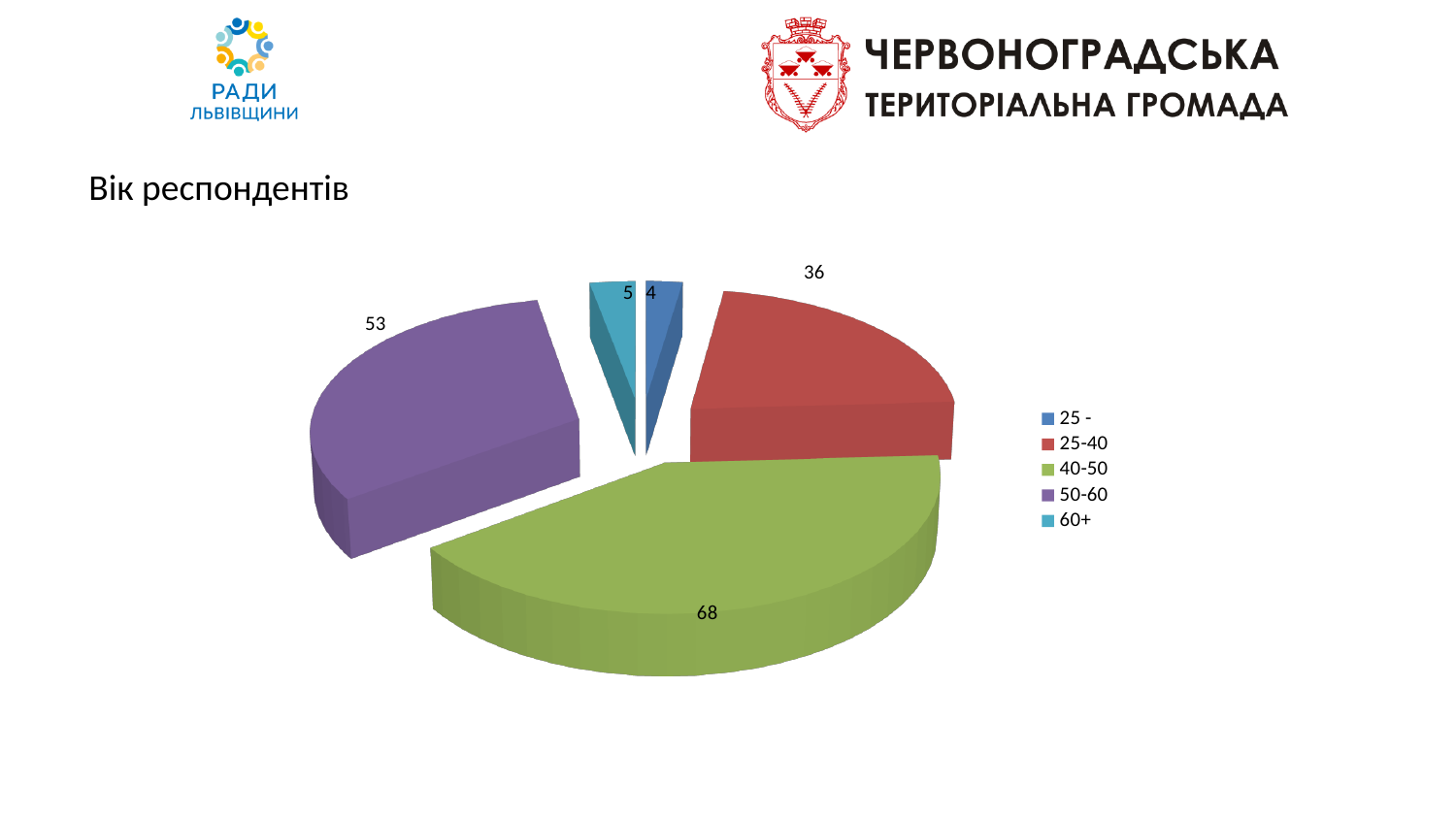
What is the value for the 60+ age group? 5 What is the difference between the values for the 40-50 and 50-60 age groups? 15 Which age group has the smallest slice of the pie? 25 - What is the value for the 25 - age group? 4 What is the value for the 25-40 age group? 36 How many age groups does the legend list? 5 Which age group has the largest slice of the pie? 40-50 What type of chart is shown on the slide? pie chart Which is larger, the value for 25-40 or the value for 50-60? 50-60 What is the value for the 40-50 age group? 68 What is the title of the chart? Вік респондентів What is the value for the 50-60 age group? 53